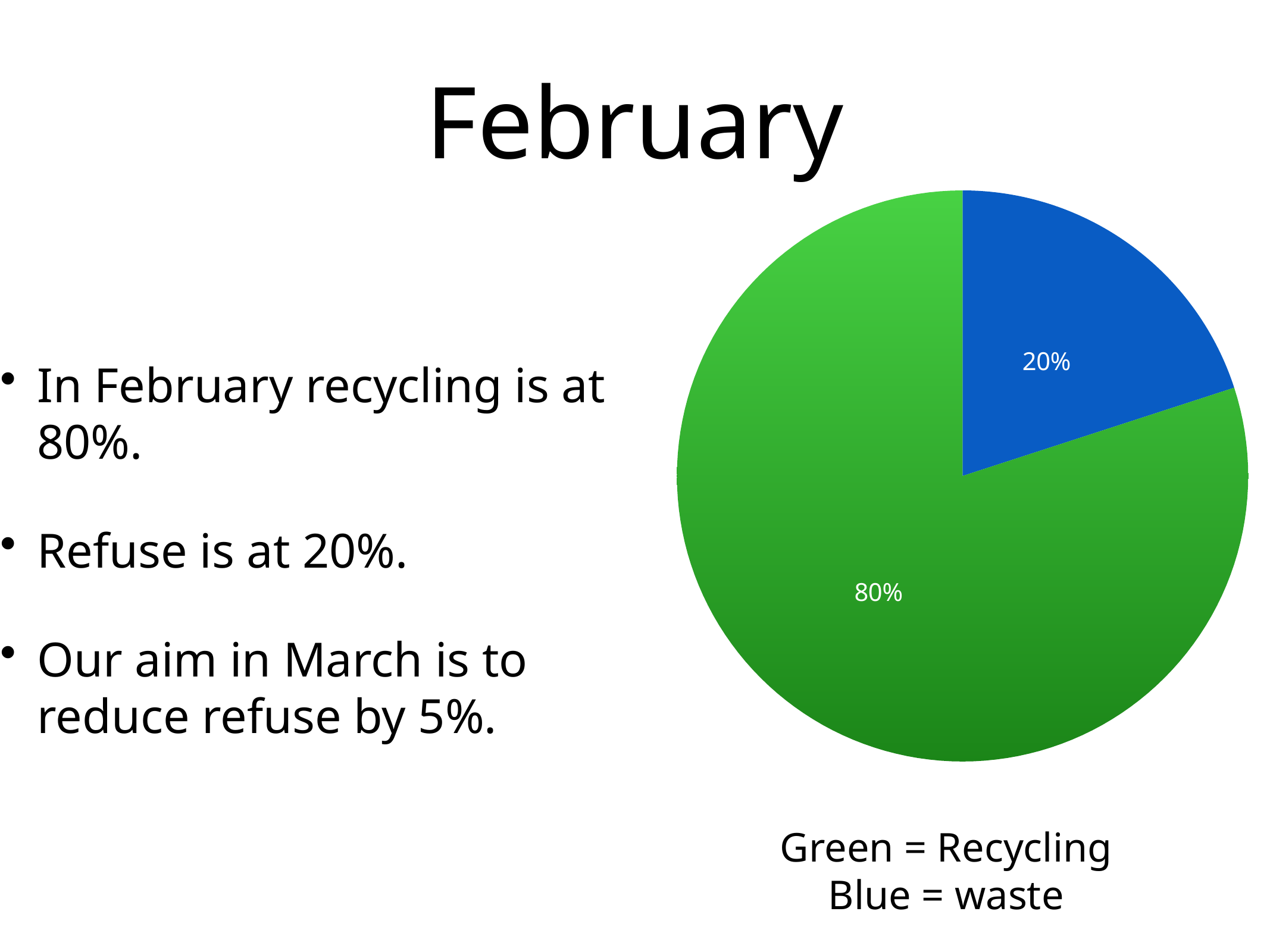
Which slice of the pie is the largest? Recycling (green) What is the difference in percentage points between the Recycling slice and the waste slice? 60% Which is larger, the Recycling slice or the waste slice? Recycling Which slice of the pie is the smallest? waste (blue) What does the green colour in the pie chart represent according to the slide? Recycling What is the total of the two slices shown in the pie chart? 100% What share of the pie does the blue (waste) slice represent? 20% What kind of chart is shown on the slide? pie chart How many slices does the pie chart have? 2 What does the blue colour in the pie chart represent according to the slide? waste What share of the pie does the green (Recycling) slice represent? 80%